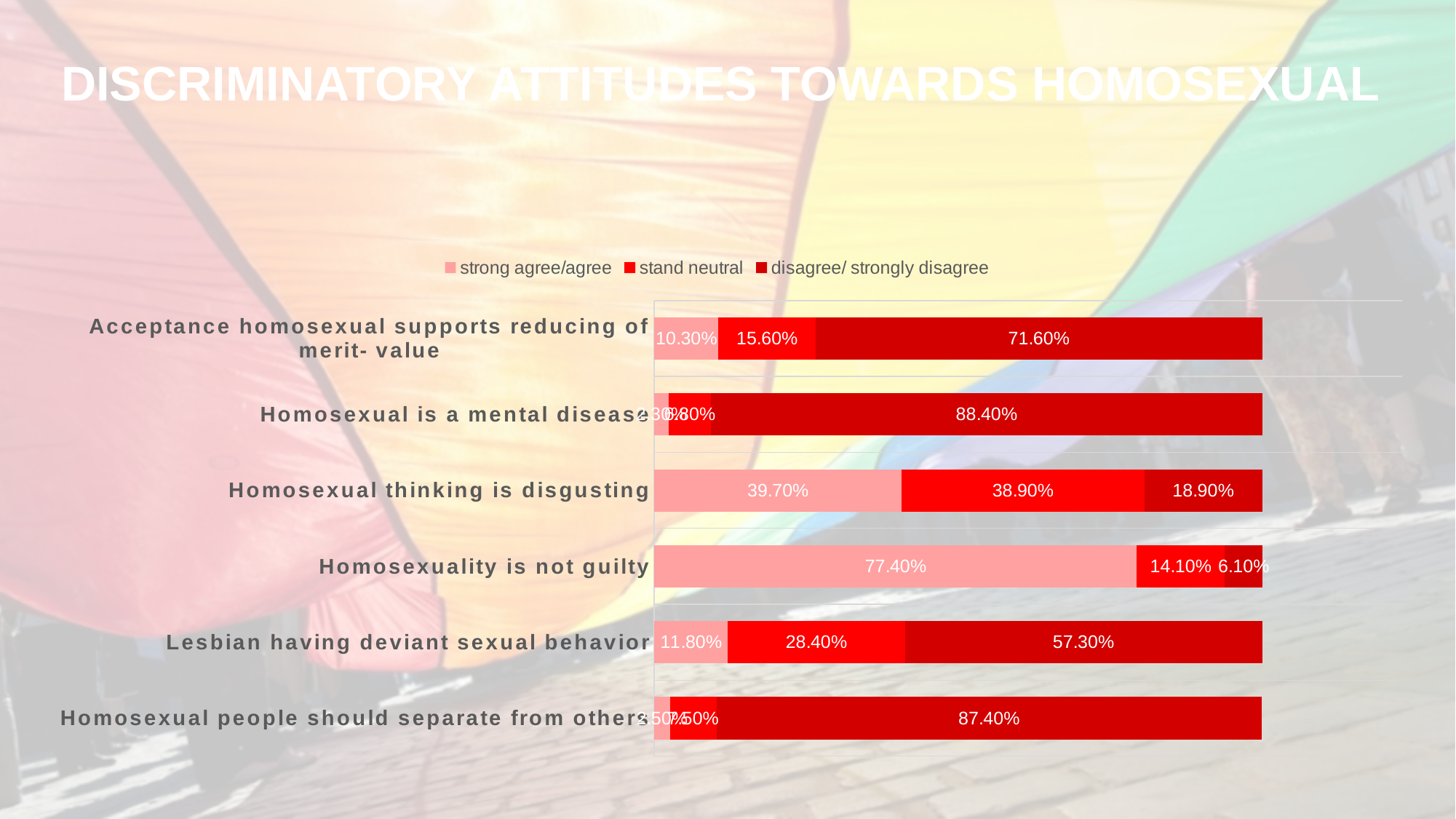
What is the 'strong agree/agree' value for 'Homosexuality is not guilty'? 77.40% How many series does the legend list? 3 What is the 'disagree/ strongly disagree' value for 'Homosexual is a mental disease'? 88.40% Which is larger for 'Homosexual thinking is disgusting': the 'strong agree/agree' value or the 'disagree/ strongly disagree' value? strong agree/agree How many categories (statements) are plotted in the chart? 6 What is the 'disagree/ strongly disagree' value for 'Homosexual thinking is disgusting'? 18.90% Which statement has the highest 'disagree/ strongly disagree' value? Homosexual is a mental disease What kind of chart is shown on the slide? stacked bar chart Which statement has the lowest 'disagree/ strongly disagree' value? Homosexuality is not guilty What is the 'stand neutral' value for 'Lesbian having deviant sexual behavior'? 28.40% What is the difference between the 'disagree/ strongly disagree' value and the 'stand neutral' value for 'Acceptance homosexual supports reducing of merit- value'? 56.00% Which legend entry is shown in the darkest red colour? disagree/ strongly disagree